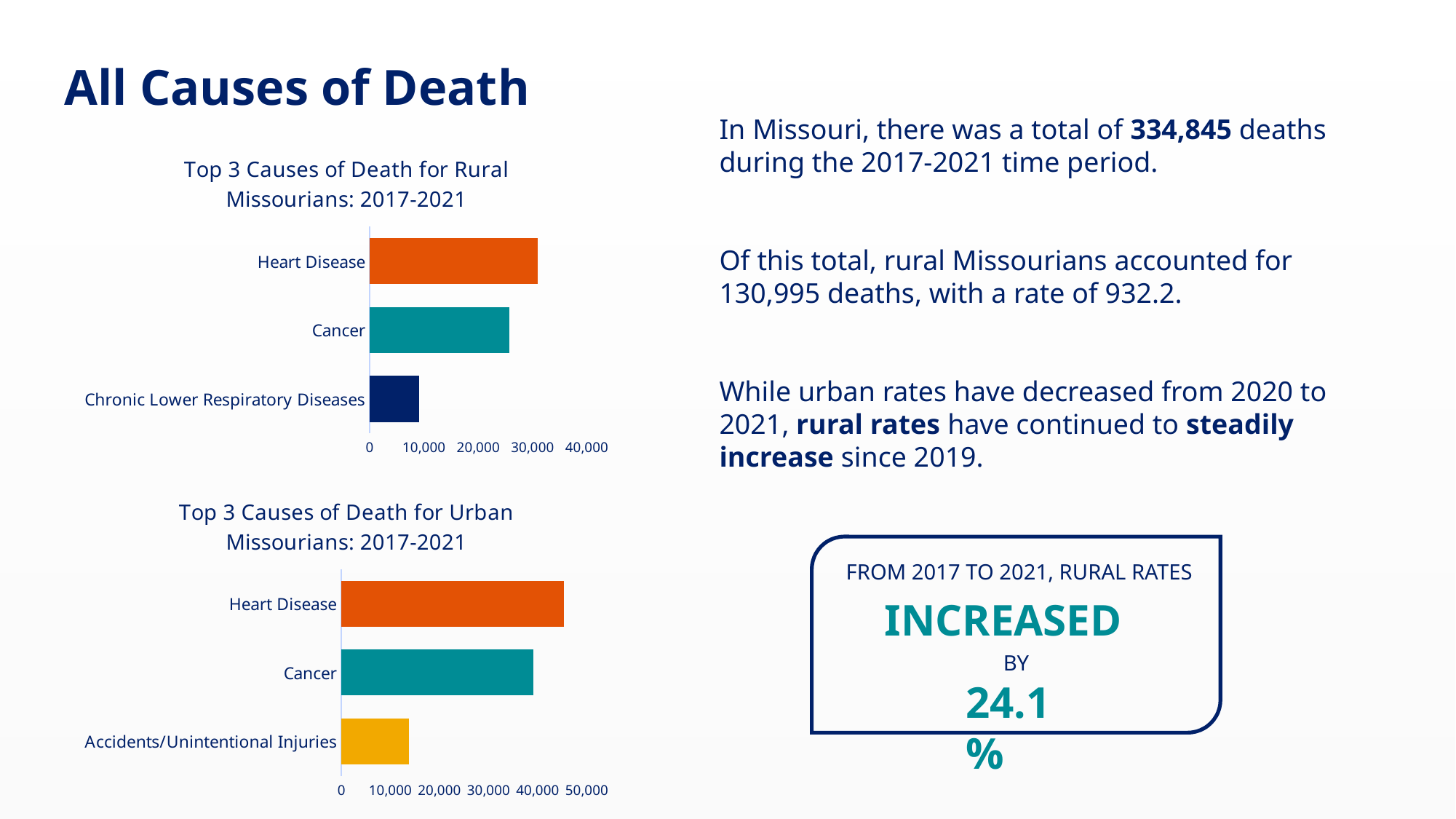
In the 'Top 3 Causes of Death for Rural Missourians: 2017-2021' chart, which cause of death has the lowest value? Chronic Lower Respiratory Diseases In the 'Top 3 Causes of Death for Urban Missourians: 2017-2021' chart, is the value for Accidents/Unintentional Injuries greater or less than 20,000? less In the 'Top 3 Causes of Death for Urban Missourians: 2017-2021' chart, which cause of death has the highest value? Heart Disease What kind of chart is the 'Top 3 Causes of Death for Rural Missourians: 2017-2021' chart? Bar chart In the 'Top 3 Causes of Death for Urban Missourians: 2017-2021' chart, which is larger, the value for Cancer or the value for Accidents/Unintentional Injuries? Cancer In the 'Top 3 Causes of Death for Urban Missourians: 2017-2021' chart, is the value for Heart Disease greater or less than 40,000? greater In the 'Top 3 Causes of Death for Rural Missourians: 2017-2021' chart, which cause of death has the highest value? Heart Disease In the 'Top 3 Causes of Death for Rural Missourians: 2017-2021' chart, is the value for Cancer greater or less than 20,000? greater In the 'Top 3 Causes of Death for Urban Missourians: 2017-2021' chart, which cause of death has the lowest value? Accidents/Unintentional Injuries How many causes of death are shown in the 'Top 3 Causes of Death for Rural Missourians: 2017-2021' chart? 3 In the 'Top 3 Causes of Death for Urban Missourians: 2017-2021' chart, what colour is the bar for Accidents/Unintentional Injuries? Yellow